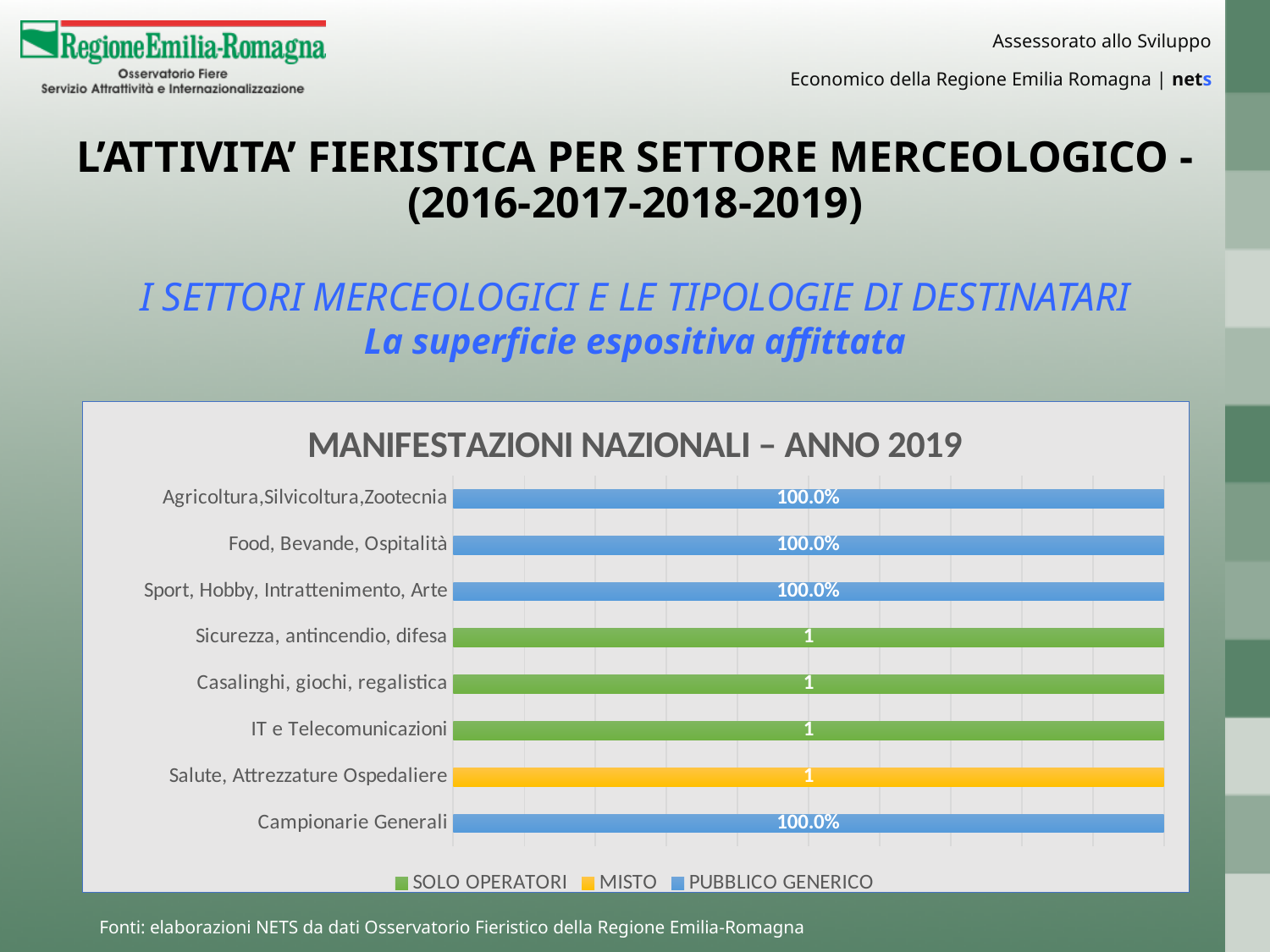
What value is printed on the bar for Sicurezza, antincendio, difesa? 1 What value is printed on the bar for Agricoltura,Silvicoltura,Zootecnia? 100.0% What value is printed on the bar for Campionarie Generali? 100.0% What kind of chart is shown on the slide? bar chart Which series does the bar for Sport, Hobby, Intrattenimento, Arte belong to, according to the legend? PUBBLICO GENERICO What is the title of the chart? MANIFESTAZIONI NAZIONALI – ANNO 2019 Which series does the bar for IT e Telecomunicazioni belong to, according to the legend? SOLO OPERATORI How many series does the chart legend list? 3 What value is printed on the bar for Food, Bevande, Ospitalità? 100.0% Which series does the bar for Salute, Attrezzature Ospedaliere belong to, according to the legend? MISTO How many categories are plotted in the chart? 8 What value is printed on the bar for Salute, Attrezzature Ospedaliere? 1